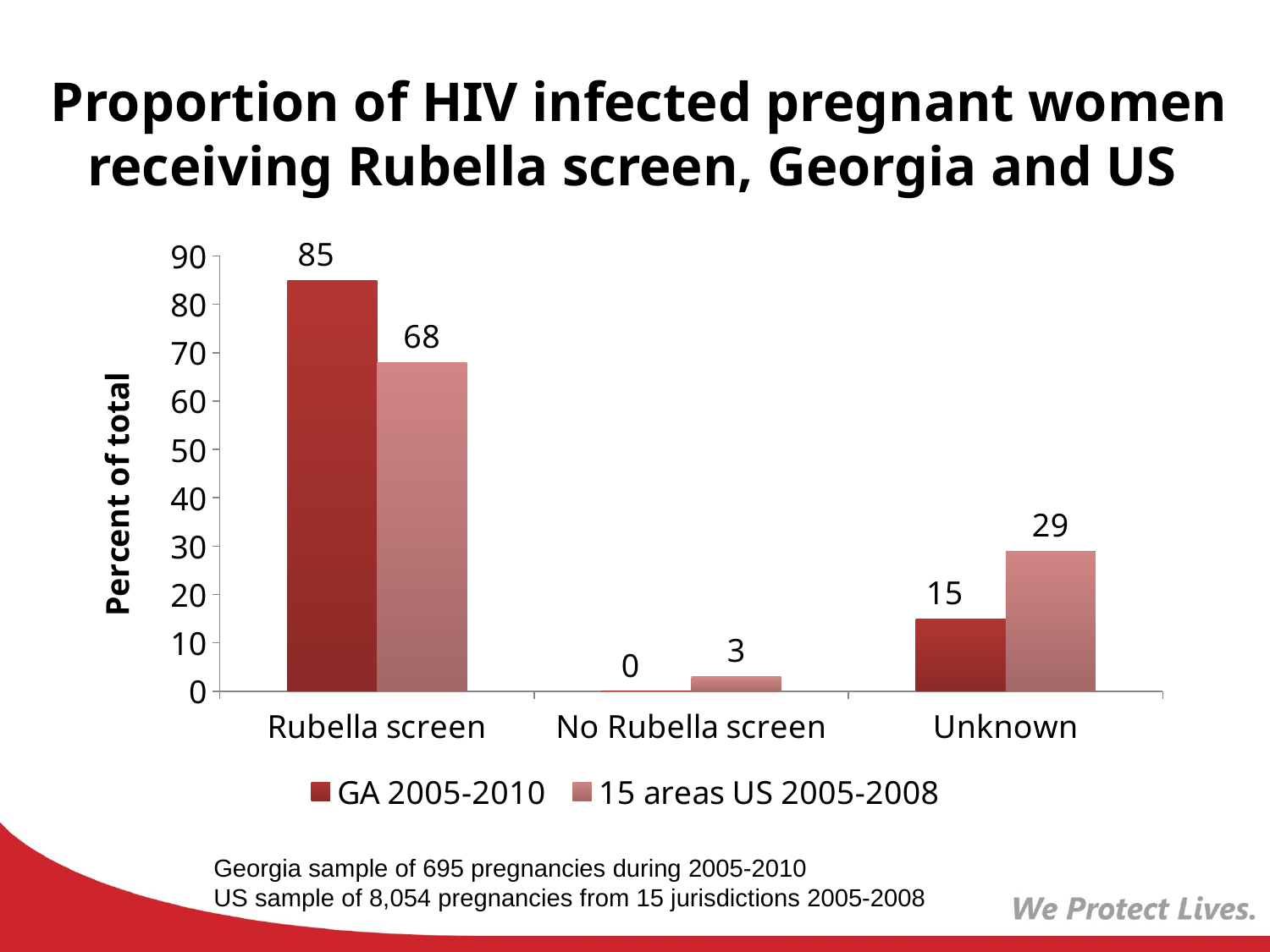
What is the value for 15 areas US 2005-2008 in the Rubella screen category? 68 How many categories are shown on the x axis? 3 Which category has the lowest value for 15 areas US 2005-2008? No Rubella screen What is the value for GA 2005-2010 in the Rubella screen category? 85 What is the difference between the 15 areas US 2005-2008 and GA 2005-2010 values in the Unknown category? 14 What is the value for 15 areas US 2005-2008 in the Unknown category? 29 What is the difference between the GA 2005-2010 and 15 areas US 2005-2008 values in the Rubella screen category? 17 What is the value for GA 2005-2010 in the No Rubella screen category? 0 What kind of chart is shown on the slide? Bar chart In the Unknown category, which series has the larger value, GA 2005-2010 or 15 areas US 2005-2008? 15 areas US 2005-2008 How many series does the legend list? 2 Which category has the highest value for GA 2005-2010? Rubella screen